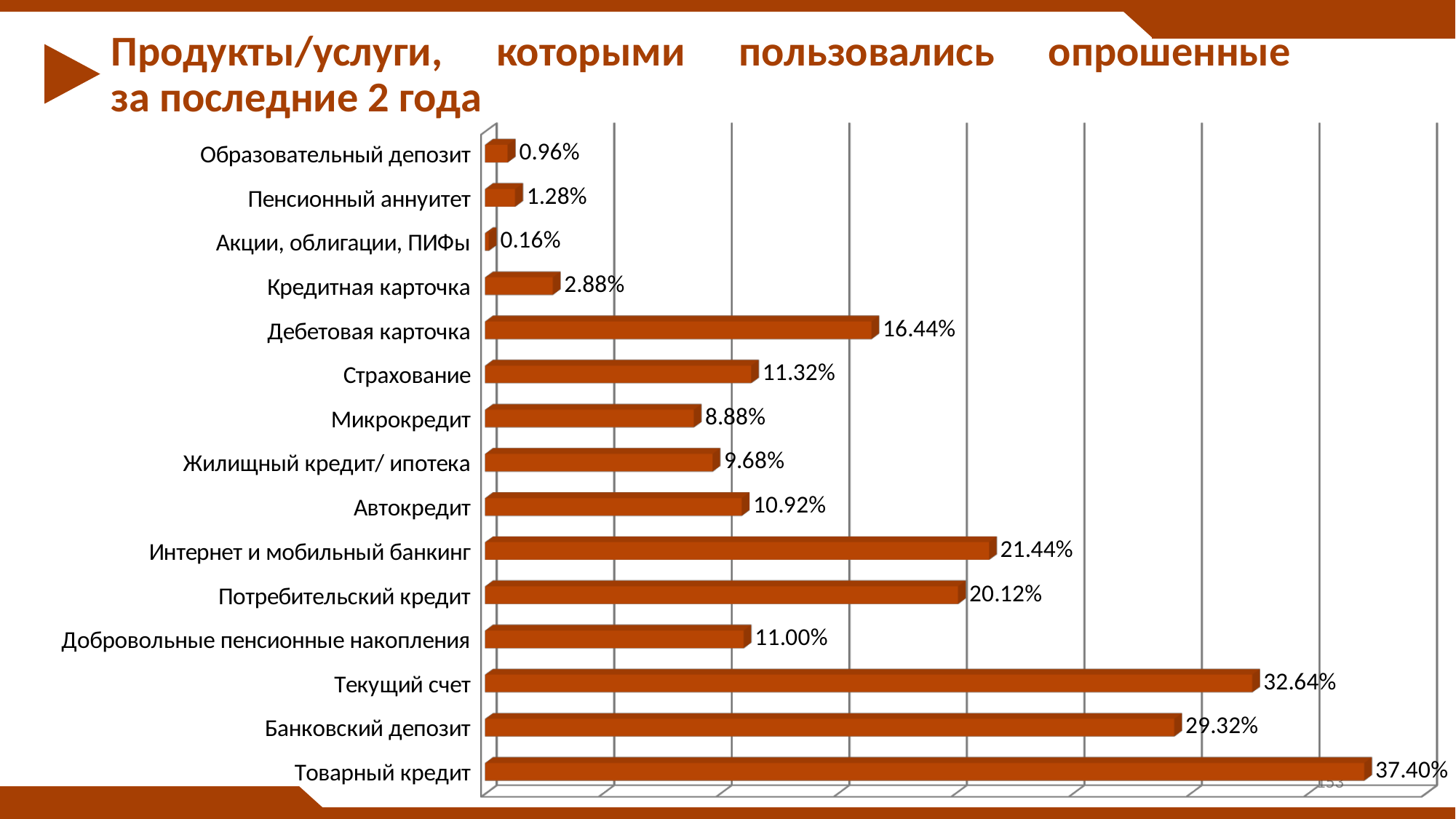
Which is larger, the value for Банковский депозит or the value for Текущий счет? Текущий счет Which category has the highest value? Товарный кредит Which is larger, the value for Микрокредит or the value for Жилищный кредит/ ипотека? Жилищный кредит/ ипотека What is the value for Акции, облигации, ПИФы? 0.16% How many categories are shown in the chart? 15 What is the difference between the values for Интернет и мобильный банкинг and Потребительский кредит? 1.32% What is the difference between the values for Товарный кредит and Текущий счет? 4.76% What is the value for Товарный кредит? 37.40% What is the value for Интернет и мобильный банкинг? 21.44% What is the value for Дебетовая карточка? 16.44% Which category has the lowest value? Акции, облигации, ПИФы What kind of chart is shown on the slide? Bar chart